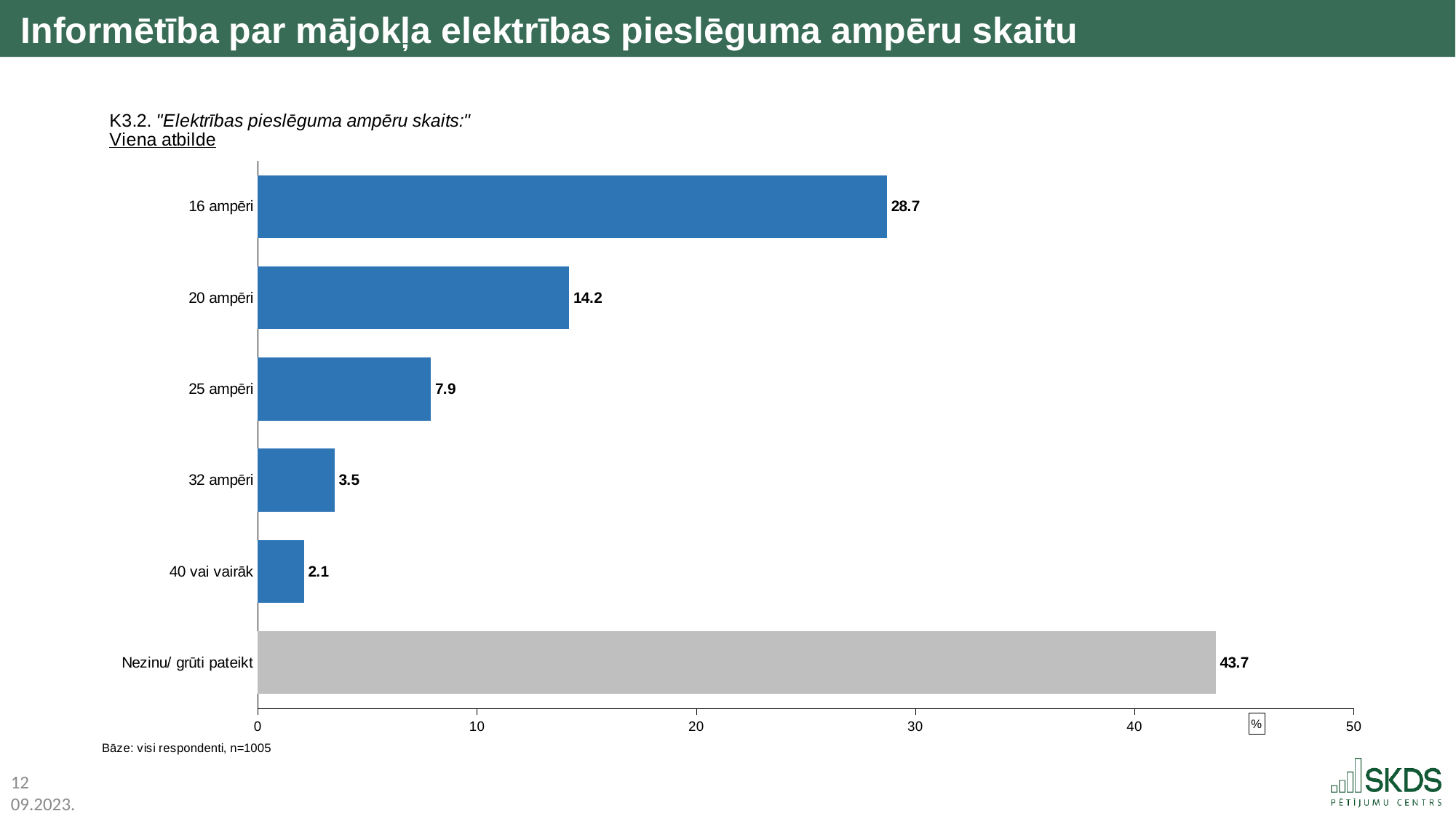
Which category has the highest value? Nezinu/ grūti pateikt What is the value for "32 ampēri"? 3.5 Which category has the lowest value? 40 vai vairāk Which is larger, the value for "25 ampēri" or the value for "32 ampēri"? 25 ampēri What is the value for "16 ampēri"? 28.7 What is the difference between the values for "Nezinu/ grūti pateikt" and "16 ampēri"? 15 What kind of chart is shown on the slide? bar chart What is the difference between the values for "16 ampēri" and "20 ampēri"? 14.5 Is the value for "20 ampēri" greater or less than 10? greater What is the base (n) stated below the chart? n=1005 What is the value for "Nezinu/ grūti pateikt"? 43.7 How many categories are shown in the chart? 6